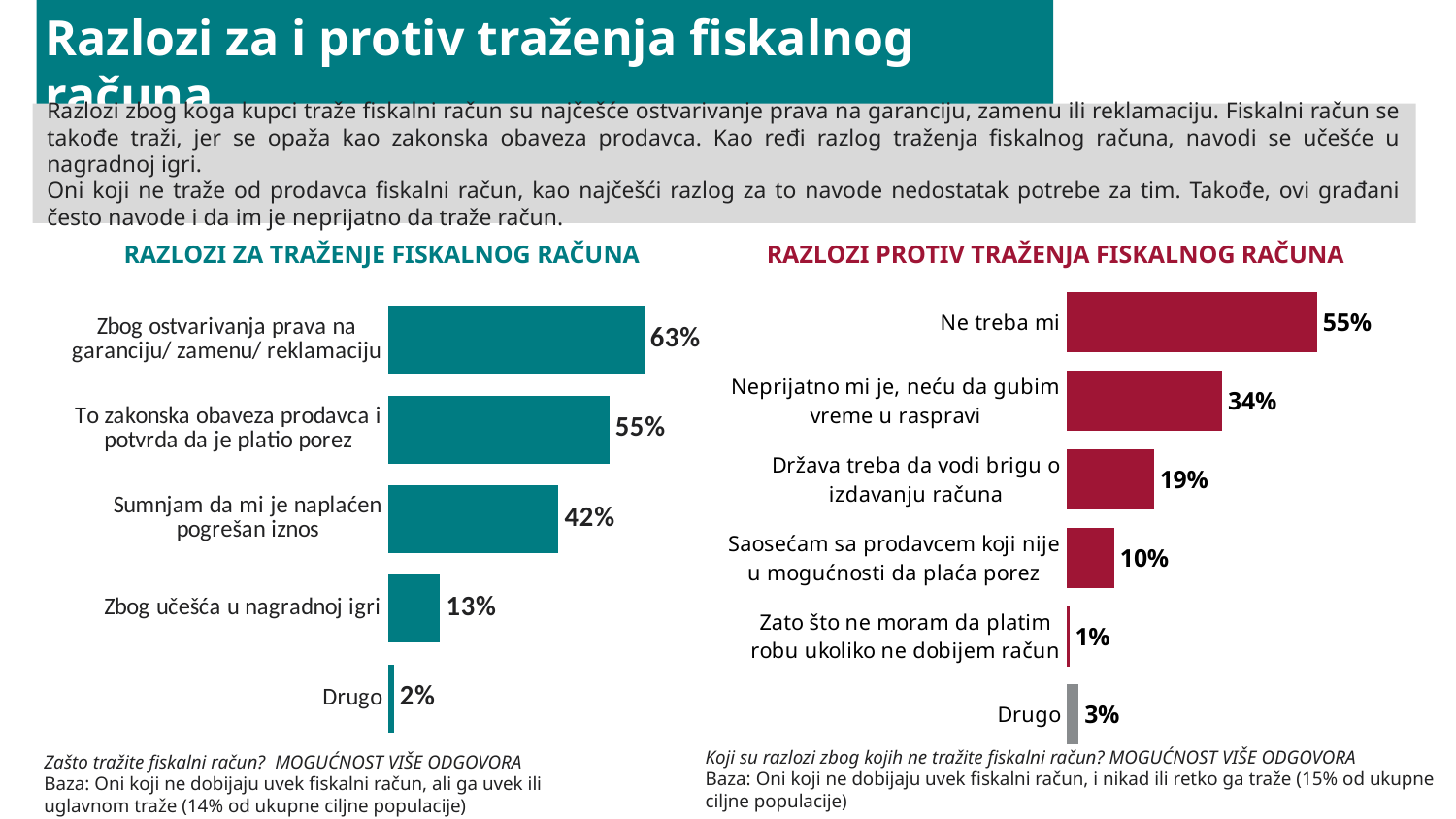
How many categories are shown in the chart 'RAZLOZI PROTIV TRAŽENJA FISKALNOG RAČUNA'? 6 In the chart 'RAZLOZI ZA TRAŽENJE FISKALNOG RAČUNA', which is larger: 'Zbog učešća u nagradnoj igri' or 'Sumnjam da mi je naplaćen pogrešan iznos'? Sumnjam da mi je naplaćen pogrešan iznos In the chart 'RAZLOZI PROTIV TRAŽENJA FISKALNOG RAČUNA', which is larger: 'Saosećam sa prodavcem koji nije u mogućnosti da plaća porez' or 'Drugo'? Saosećam sa prodavcem koji nije u mogućnosti da plaća porez In the chart 'RAZLOZI PROTIV TRAŽENJA FISKALNOG RAČUNA', which category has the highest value? Ne treba mi In the chart 'RAZLOZI PROTIV TRAŽENJA FISKALNOG RAČUNA', what is the value for 'Neprijatno mi je, neću da gubim vreme u raspravi'? 34% In the chart 'RAZLOZI PROTIV TRAŽENJA FISKALNOG RAČUNA', what is the difference between 'Ne treba mi' and 'Država treba da vodi brigu o izdavanju računa'? 36% In the chart 'RAZLOZI PROTIV TRAŽENJA FISKALNOG RAČUNA', what is the value for 'Zato što ne moram da platim robu ukoliko ne dobijem račun'? 1% In the chart 'RAZLOZI ZA TRAŽENJE FISKALNOG RAČUNA', what is the value for 'Zbog ostvarivanja prava na garanciju/ zamenu/ reklamaciju'? 63% In the chart 'RAZLOZI ZA TRAŽENJE FISKALNOG RAČUNA', what is the difference between 'To zakonska obaveza prodavca i potvrda da je platio porez' and 'Sumnjam da mi je naplaćen pogrešan iznos'? 13% What type of chart is 'RAZLOZI PROTIV TRAŽENJA FISKALNOG RAČUNA'? Bar chart How many categories are shown in the chart 'RAZLOZI ZA TRAŽENJE FISKALNOG RAČUNA'? 5 In the chart 'RAZLOZI ZA TRAŽENJE FISKALNOG RAČUNA', which category has the lowest value? Drugo